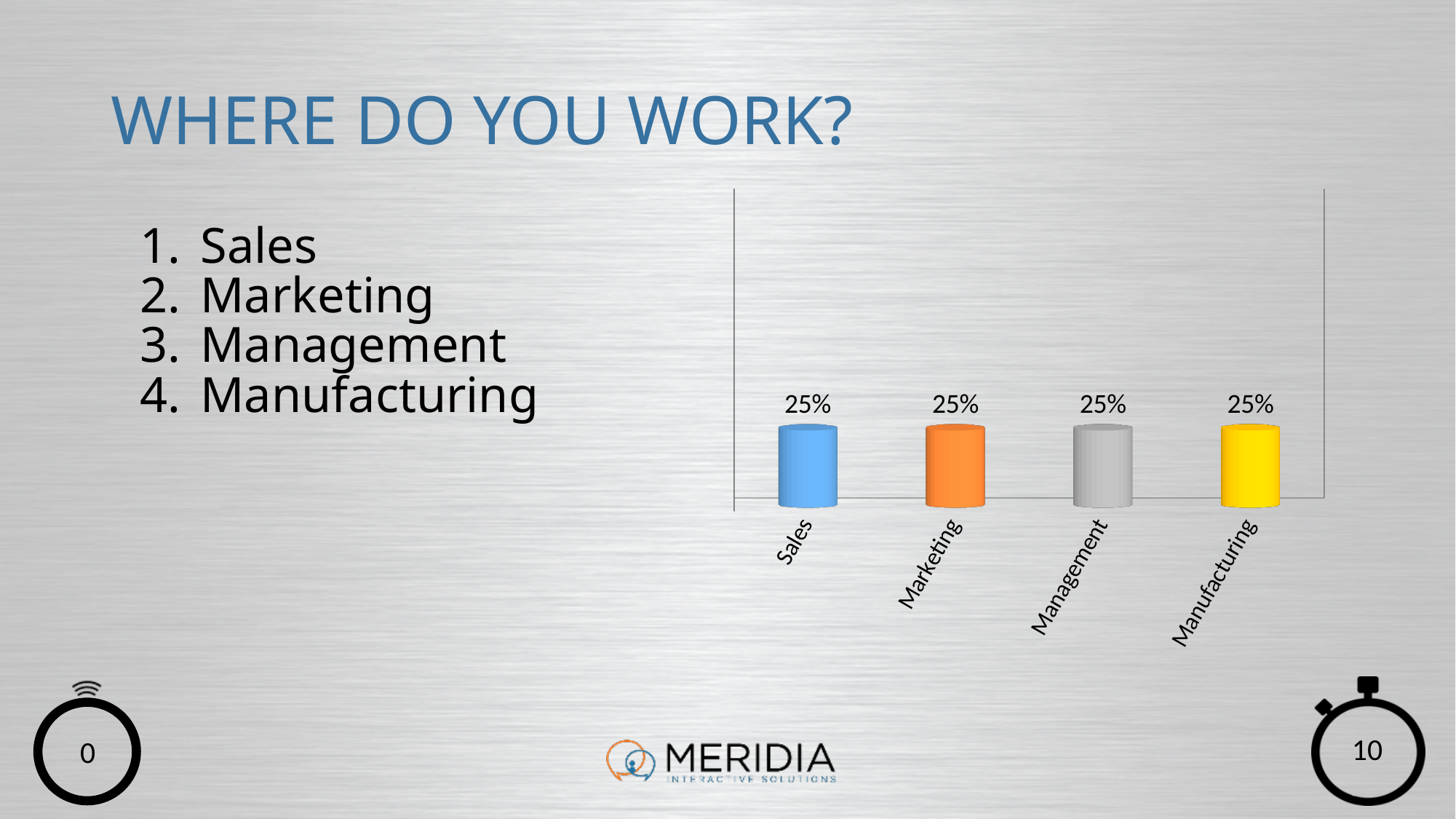
What is the total of the four values shown in the chart? 100% How many categories are shown in the chart? 4 What colour is the bar for Marketing? orange What is the value for Manufacturing? 25% What is the value for Sales? 25% Which category is represented by the yellow bar? Manufacturing What is the difference between the values for Sales and Manufacturing? 0% What kind of chart is shown on the slide? bar chart What is the value for Management? 25% What is the value for Marketing? 25% Do the values rise, fall, or stay the same across the categories from Sales to Manufacturing? stay the same